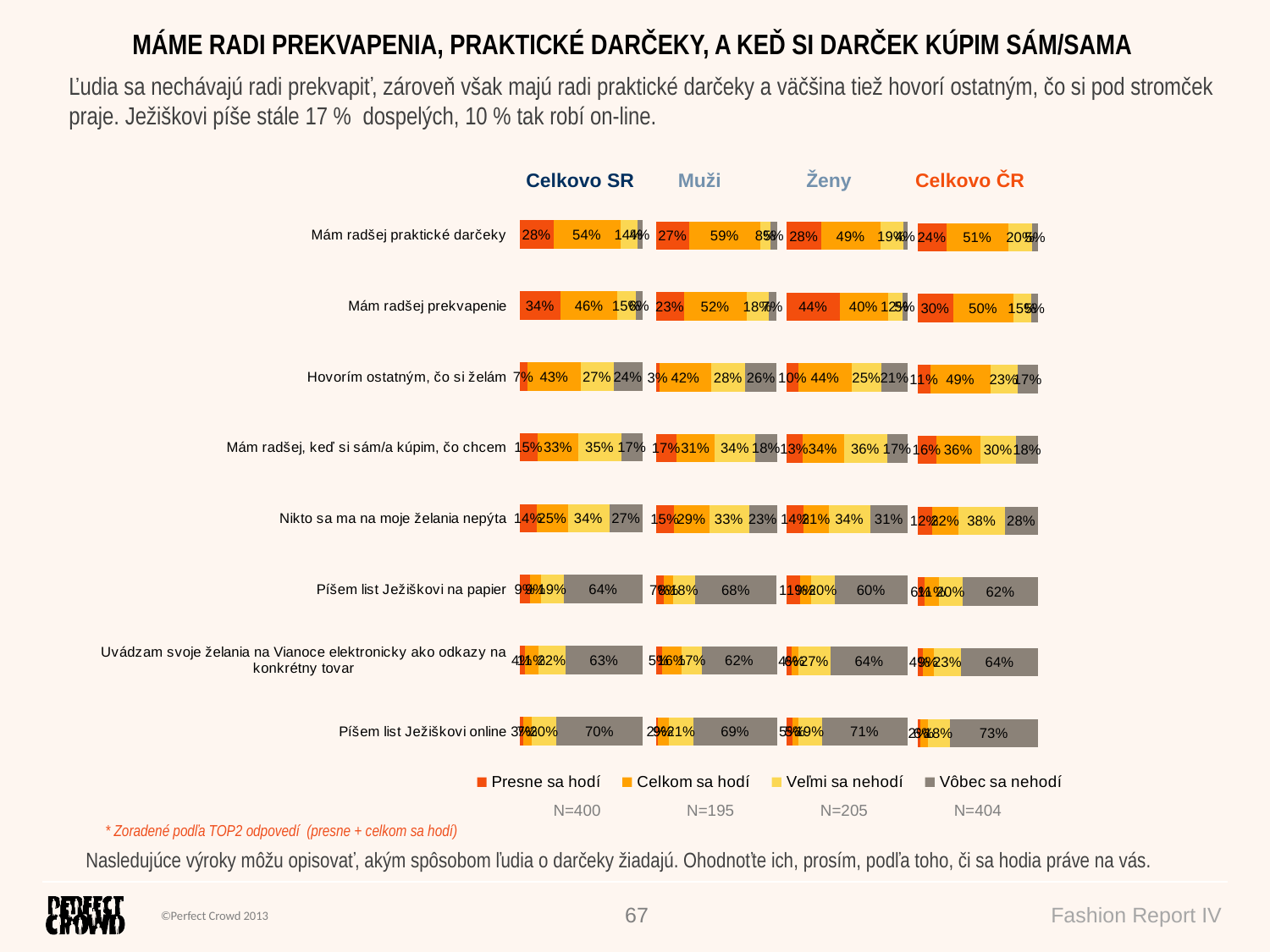
In the Muži chart, what is the 'Celkom sa hodí' value for 'Mám radšej praktické darčeky'? 59% In the Celkovo SR chart, which statement has the highest 'Vôbec sa nehodí' value? Píšem list Ježiškovi online What kind of chart is used for the Celkovo ČR data? Stacked bar chart In the Celkovo ČR chart, what is the 'Presne sa hodí' value for 'Hovorím ostatným, čo si želám'? 11% In the Celkovo ČR chart, what is the 'Vôbec sa nehodí' value for 'Píšem list Ježiškovi online'? 73% What is the sample size (N) shown under the Ženy chart? N=205 In the Celkovo SR chart, what is the 'Presne sa hodí' value for 'Mám radšej praktické darčeky'? 28% In the Ženy chart, what is the 'Presne sa hodí' value for 'Mám radšej prekvapenie'? 44% In the Ženy chart, which is larger for 'Nikto sa ma na moje želania nepýta': 'Veľmi sa nehodí' or 'Vôbec sa nehodí'? Veľmi sa nehodí In the Muži chart, what is the difference between the 'Celkom sa hodí' values for 'Mám radšej prekvapenie' (52%) and 'Hovorím ostatným, čo si želám' (42%)? 10% How many statements (categories) are shown in the Celkovo SR chart? 8 How many series does the legend list? 4